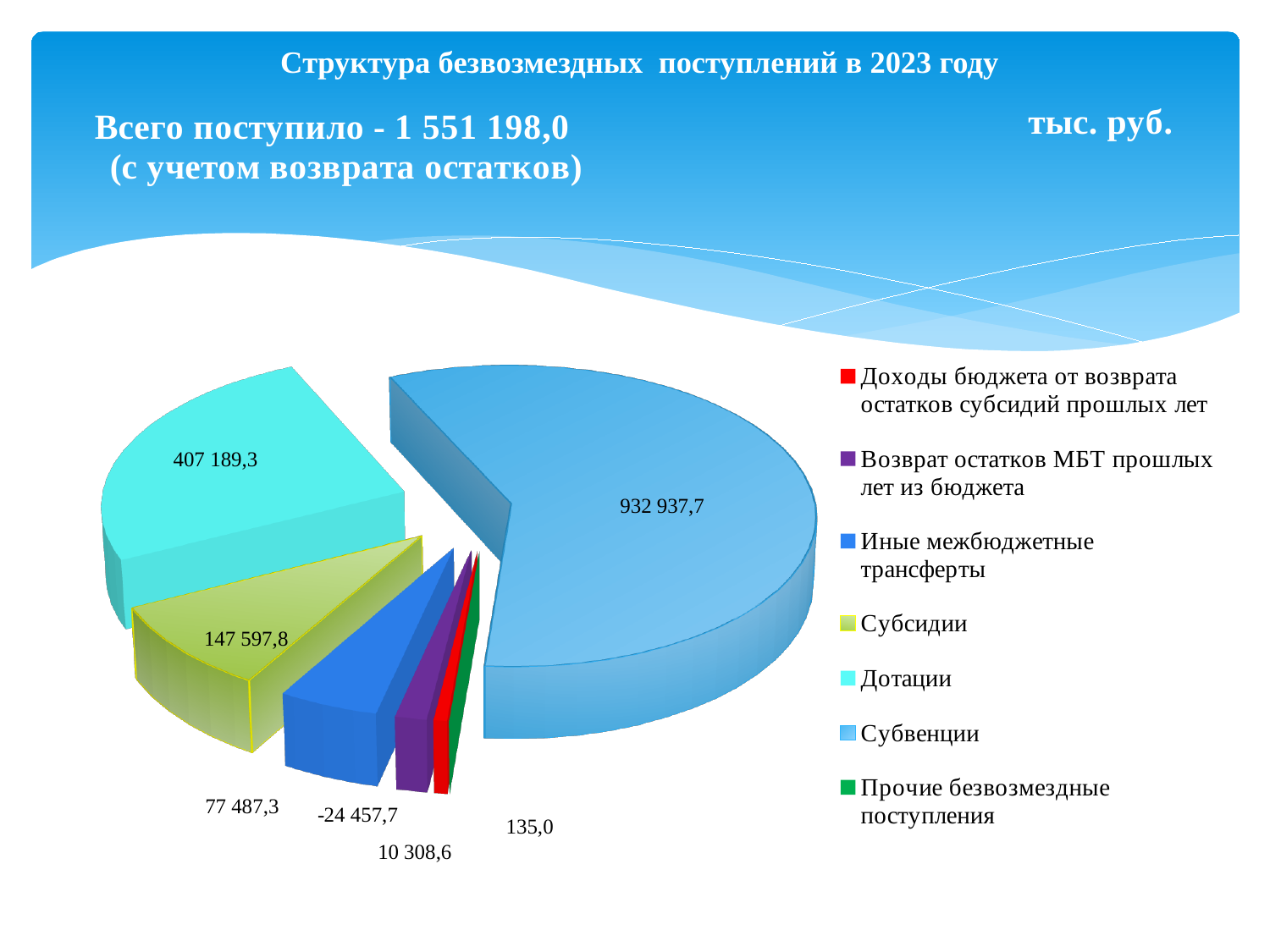
Which is larger, the value for Дотации or the value for Субсидии? Дотации What is the difference between the values for Субвенции and Дотации? 525 748,4 What is the value for Возврат остатков МБТ прошлых лет из бюджета in the pie chart? -24 457,7 Which category has the largest slice in the pie chart? Субвенции What total amount (Всего поступило) is stated on the slide? 1 551 198,0 How many categories does the legend of the pie chart list? 7 What is the value for Субвенции in the pie chart? 932 937,7 What is the title of the chart on the slide? Всего поступило - 1 551 198,0 (с учетом возврата остатков) What is the value for Дотации in the pie chart? 407 189,3 What kind of chart is shown on the slide? pie chart What is the value for Субсидии in the pie chart? 147 597,8 What is the value for Иные межбюджетные трансферты in the pie chart? 77 487,3